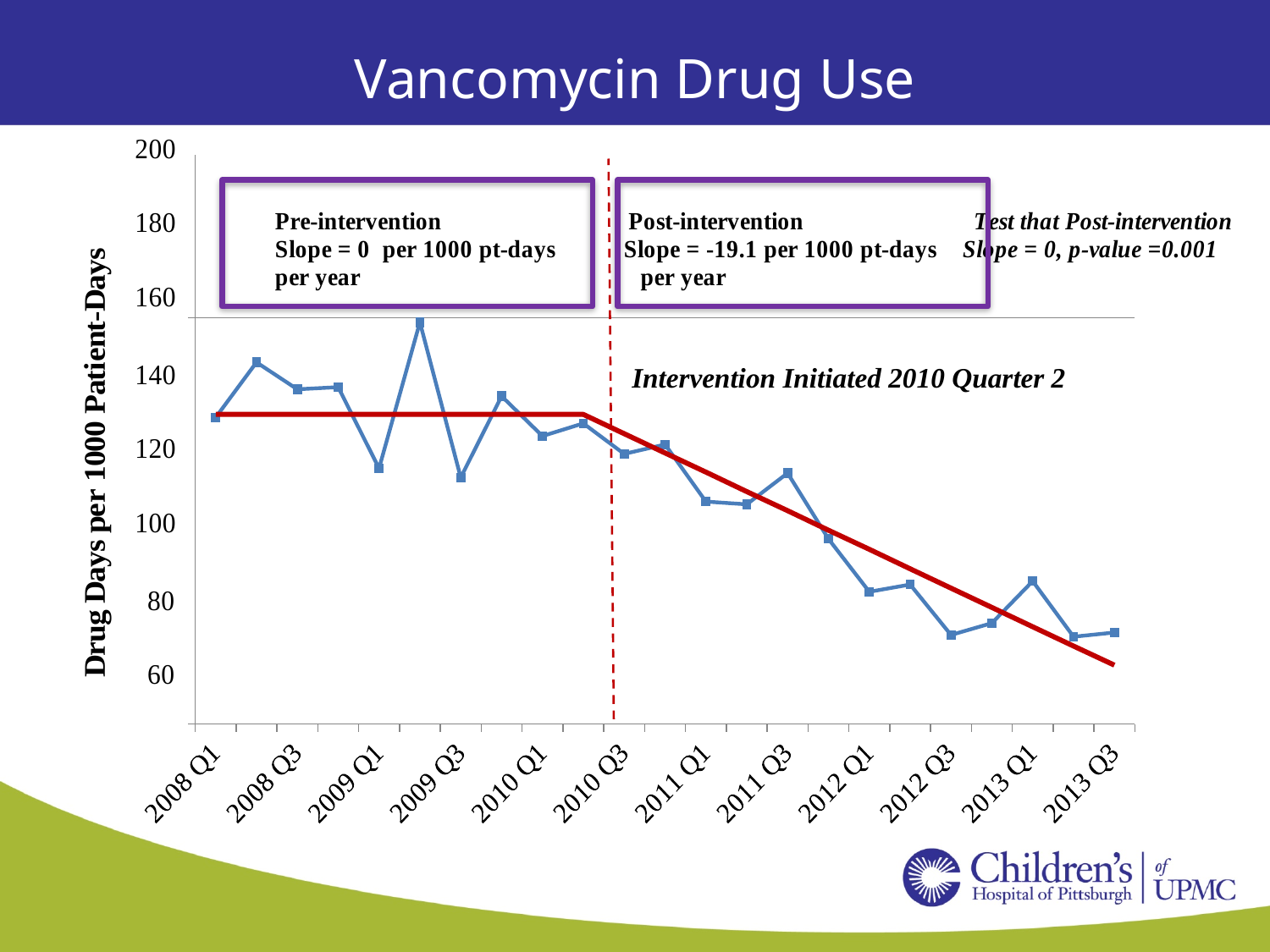
Do the values generally rise or fall from 2010 Q3 to 2013 Q3? fall According to the annotation on the chart, when was the intervention initiated? 2010 Quarter 2 Which is larger, the value for 2008 Q1 or the value for 2013 Q1? 2008 Q1 Is the value for 2012 Q3 greater or less than 80? less Which is larger, the value for 2009 Q2 or the value for 2011 Q4? 2009 Q2 Is the value for 2008 Q1 greater or less than 120? greater Is the value for 2011 Q3 greater or less than 100? greater What is the post-intervention slope stated on the chart? -19.1 per 1000 pt-days per year Which quarter has the highest value for drug days per 1000 patient-days? 2009 Q2 What kind of chart is shown on the slide? line chart